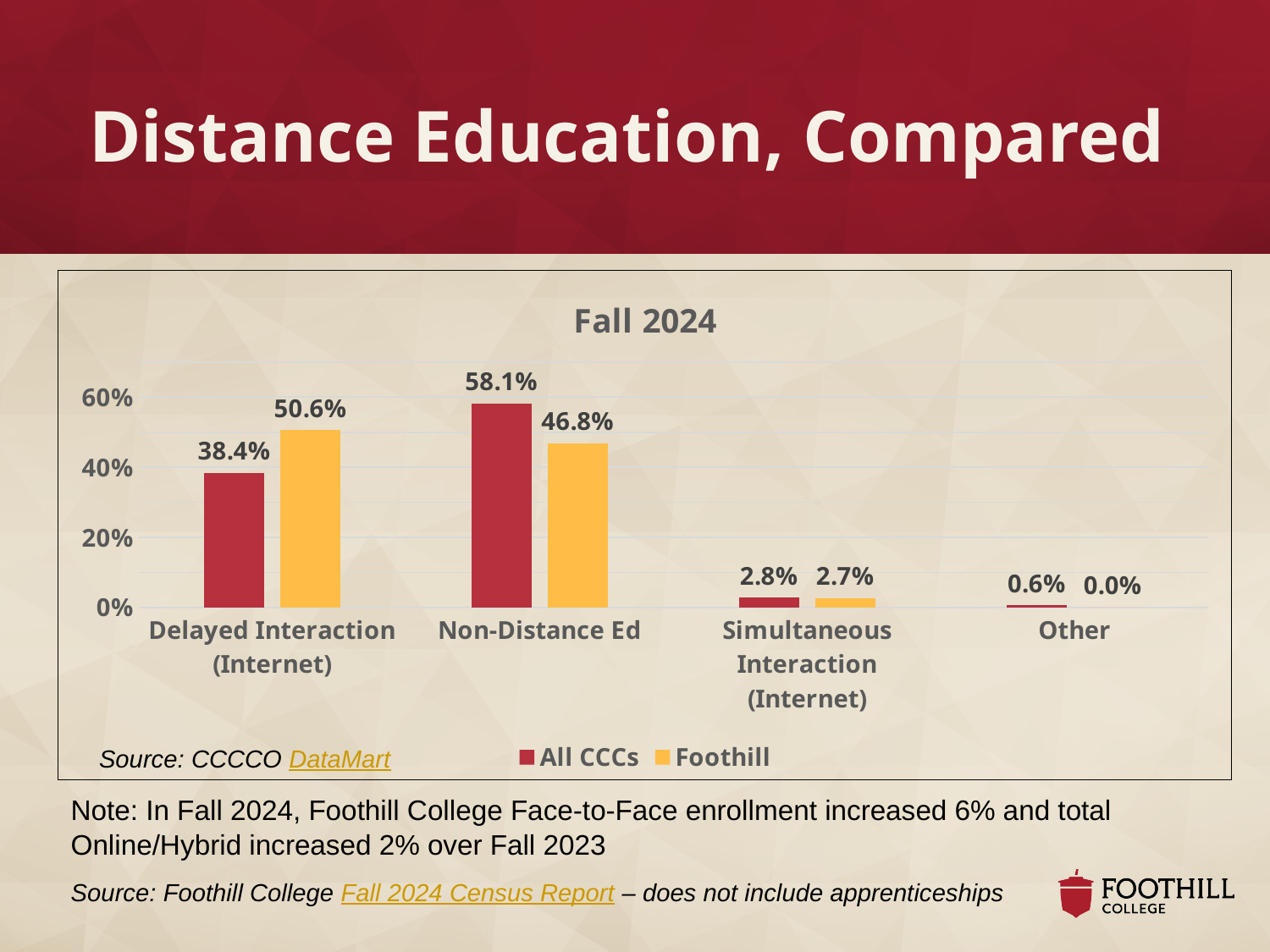
What is the Foothill value for Non-Distance Ed? 46.8% What is the difference between the All CCCs and Foothill values for Non-Distance Ed? 11.3% Which category has the highest All CCCs value? Non-Distance Ed Is the All CCCs value for Non-Distance Ed greater or less than 40%? greater What is the Foothill value for Other? 0.0% How many categories are shown on the x axis? 4 How many series does the legend list? 2 What is the All CCCs value for Delayed Interaction (Internet)? 38.4% What is the difference between the Foothill and All CCCs values for Delayed Interaction (Internet)? 12.2% For Delayed Interaction (Internet), which is larger: All CCCs or Foothill? Foothill What type of chart is shown? Bar chart Which category has the lowest Foothill value? Other